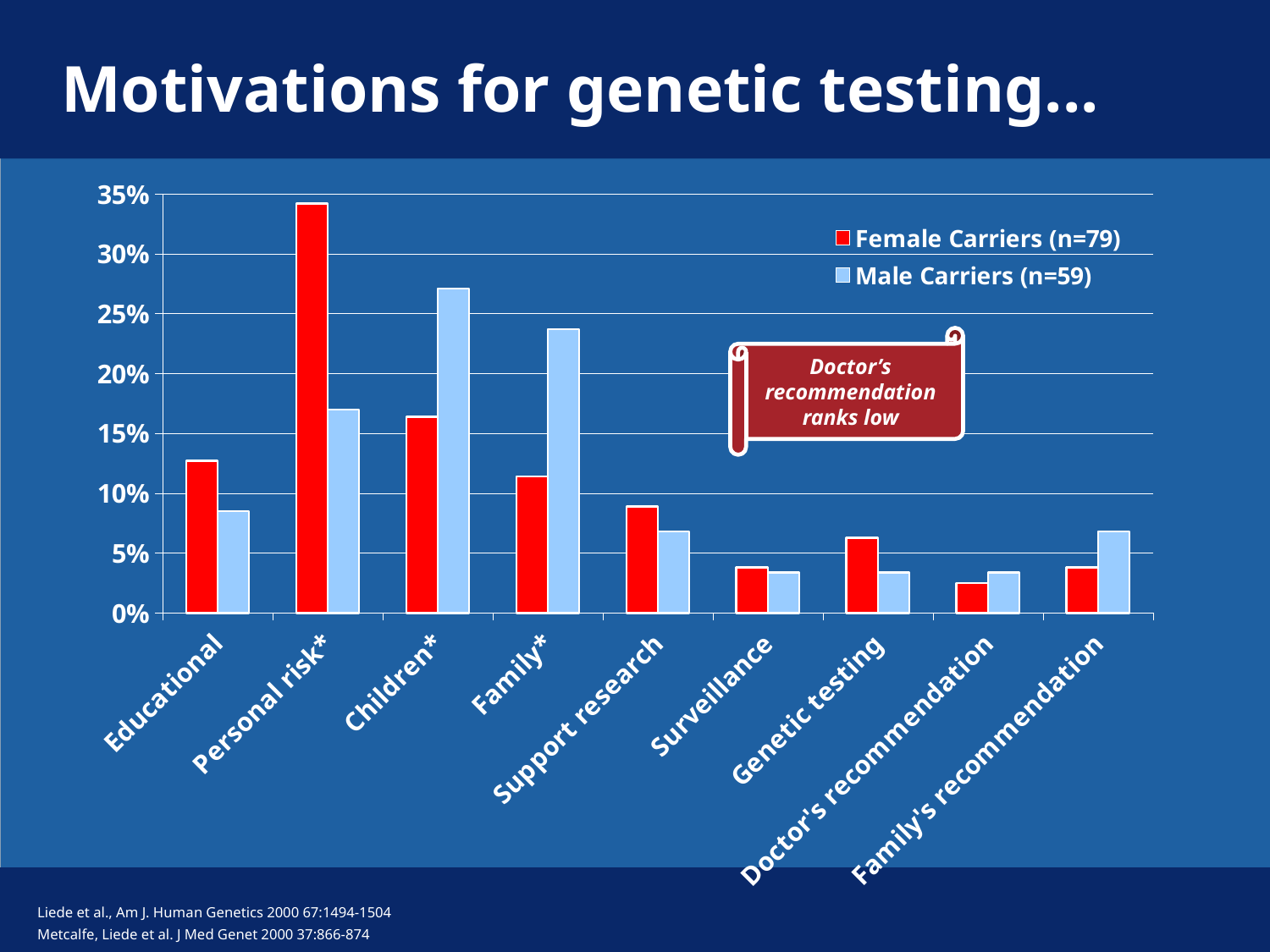
For Children*, which series has the larger value, Female Carriers or Male Carriers? Male Carriers (n=59) Is the Male Carriers value for Children* greater or less than 25%? greater Which category has the highest value for Male Carriers (n=59)? Children* Is the Female Carriers value for Personal risk* greater or less than 30%? greater Which category has the lowest value for Female Carriers (n=79)? Doctor's recommendation Is the Female Carriers value for Doctor's recommendation greater or less than 5%? less Which category has the highest value for Female Carriers (n=79)? Personal risk* What kind of chart is shown on the slide? bar chart What does the red callout box on the chart say? Doctor's recommendation ranks low How many motivation categories are shown on the x axis? 9 For Educational, which series has the larger value, Female Carriers or Male Carriers? Female Carriers (n=79) How many series does the legend list? 2